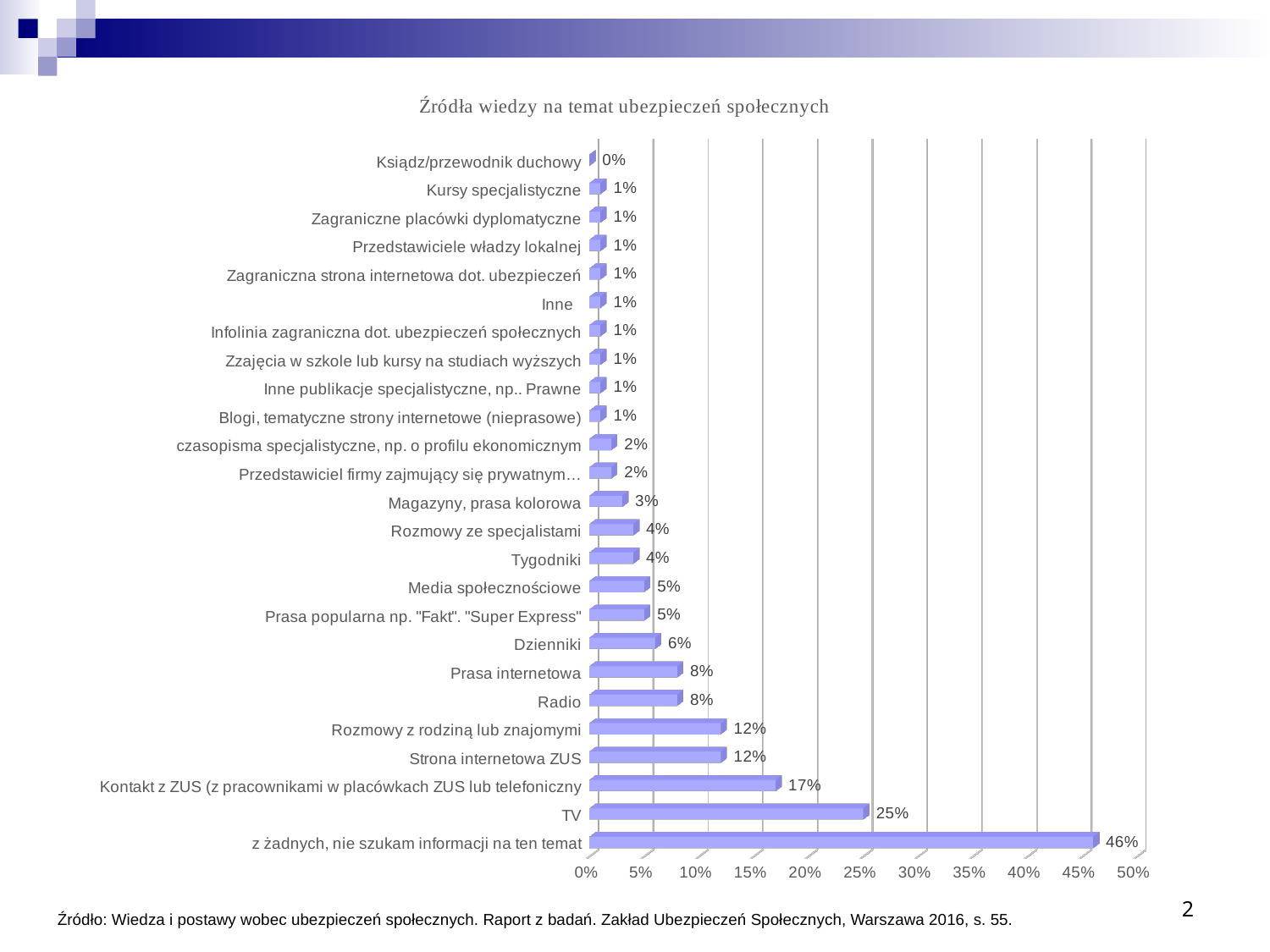
Which category has the highest value? z żadnych, nie szukam informacji na ten temat How many categories are shown in the chart? 25 What is the difference between the values for TV and Strona internetowa ZUS? 13% Which category has the lowest value? Ksiądz/przewodnik duchowy What is the difference between the values for z żadnych, nie szukam informacji na ten temat and TV? 21% What is the title of the chart? Źródła wiedzy na temat ubezpieczeń społecznych What is the value for Kontakt z ZUS (z pracownikami w placówkach ZUS lub telefoniczny)? 17% What is the value for Radio? 8% What is the value for Dzienniki? 6% What type of chart is shown on the slide? Bar chart What is the value for TV? 25% Which is larger, the value for Prasa internetowa or the value for Media społecznościowe? Prasa internetowa